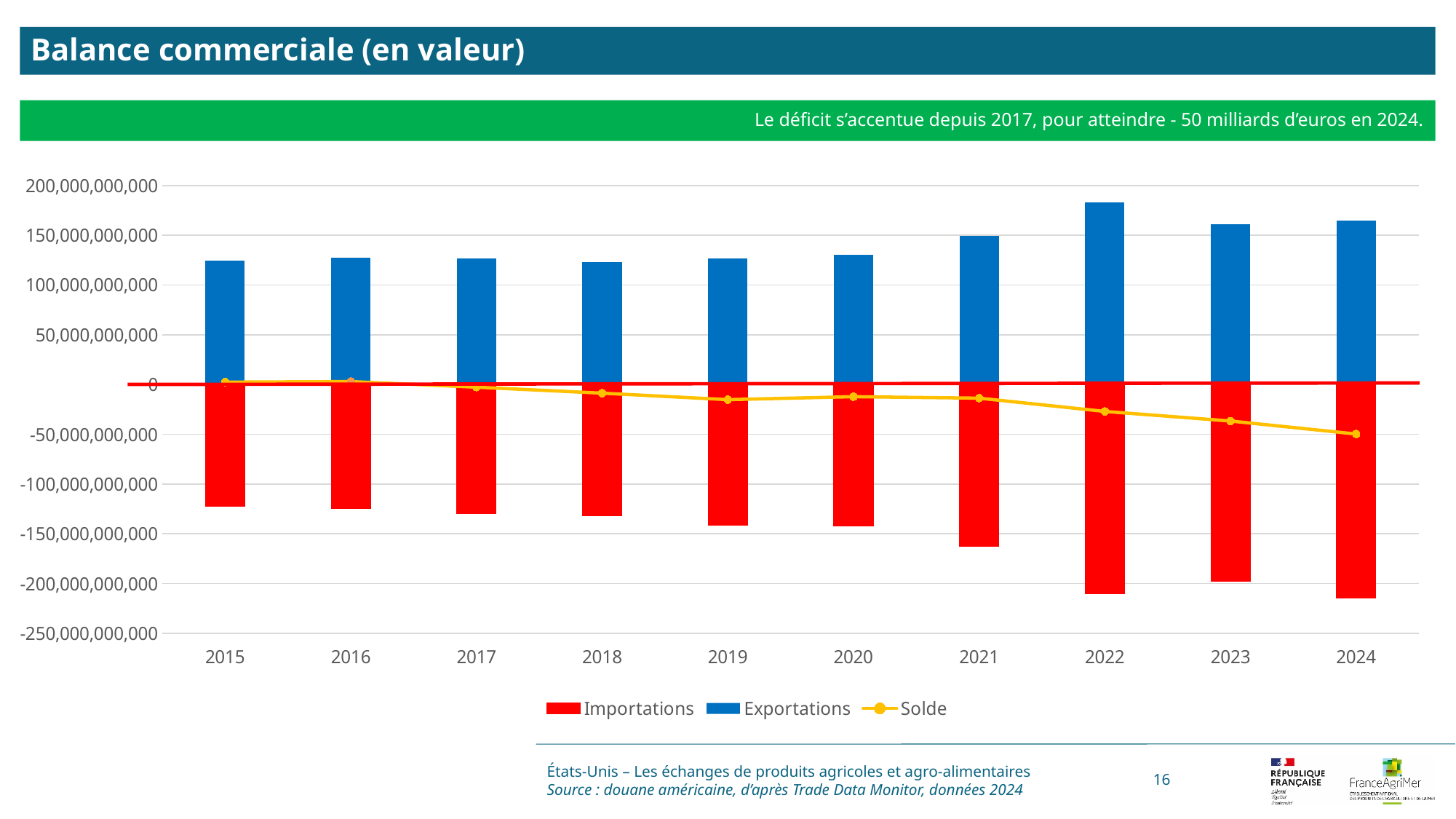
How many years are shown on the x axis of the chart? 10 Is the Importations value for 2024 greater or less than -200,000,000,000? less Is the Exportations value for 2015 greater or less than 150,000,000,000? less In which year is the Exportations bar the highest? 2022 According to the slide, what value does the deficit (Solde) reach in 2024? -50 milliards d'euros Does the Solde line rise or fall from 2017 to 2024? fall Is the Exportations value for 2022 greater or less than 150,000,000,000? greater Which is larger, the Exportations value for 2021 or for 2016? 2021 What kind of chart is shown on the slide? combination bar and line chart What colour represents Importations in the chart legend? red How many series does the chart legend list? 3